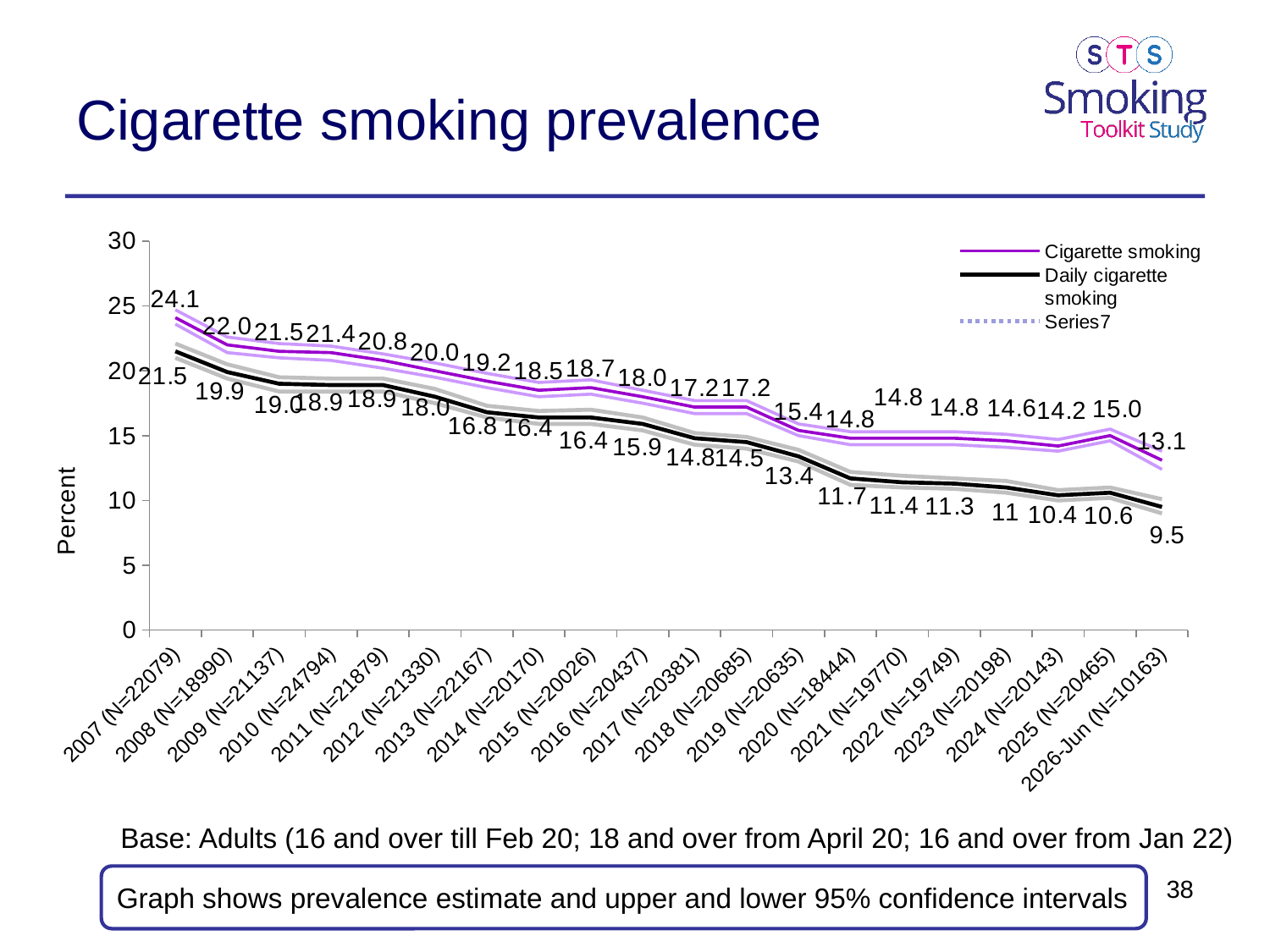
In which year is cigarette smoking prevalence highest? 2007 (N=22079) Does daily cigarette smoking prevalence generally rise or fall from 2007 to 2026-Jun? Fall What is the cigarette smoking prevalence for 2007 (N=22079)? 24.1 What is the daily cigarette smoking prevalence for 2020 (N=18444)? 11.7 What is the daily cigarette smoking prevalence for 2026-Jun (N=10163)? 9.5 By how much did cigarette smoking prevalence fall from 2007 to 2026-Jun? 11.0 What is the difference between cigarette smoking and daily cigarette smoking prevalence in 2007? 2.6 How many time periods are shown on the x axis? 20 How many entries does the legend list? 3 Which year has the higher cigarette smoking prevalence, 2024 or 2025? 2025 What kind of chart is shown on the slide? Line chart In which period is daily cigarette smoking prevalence lowest? 2026-Jun (N=10163)